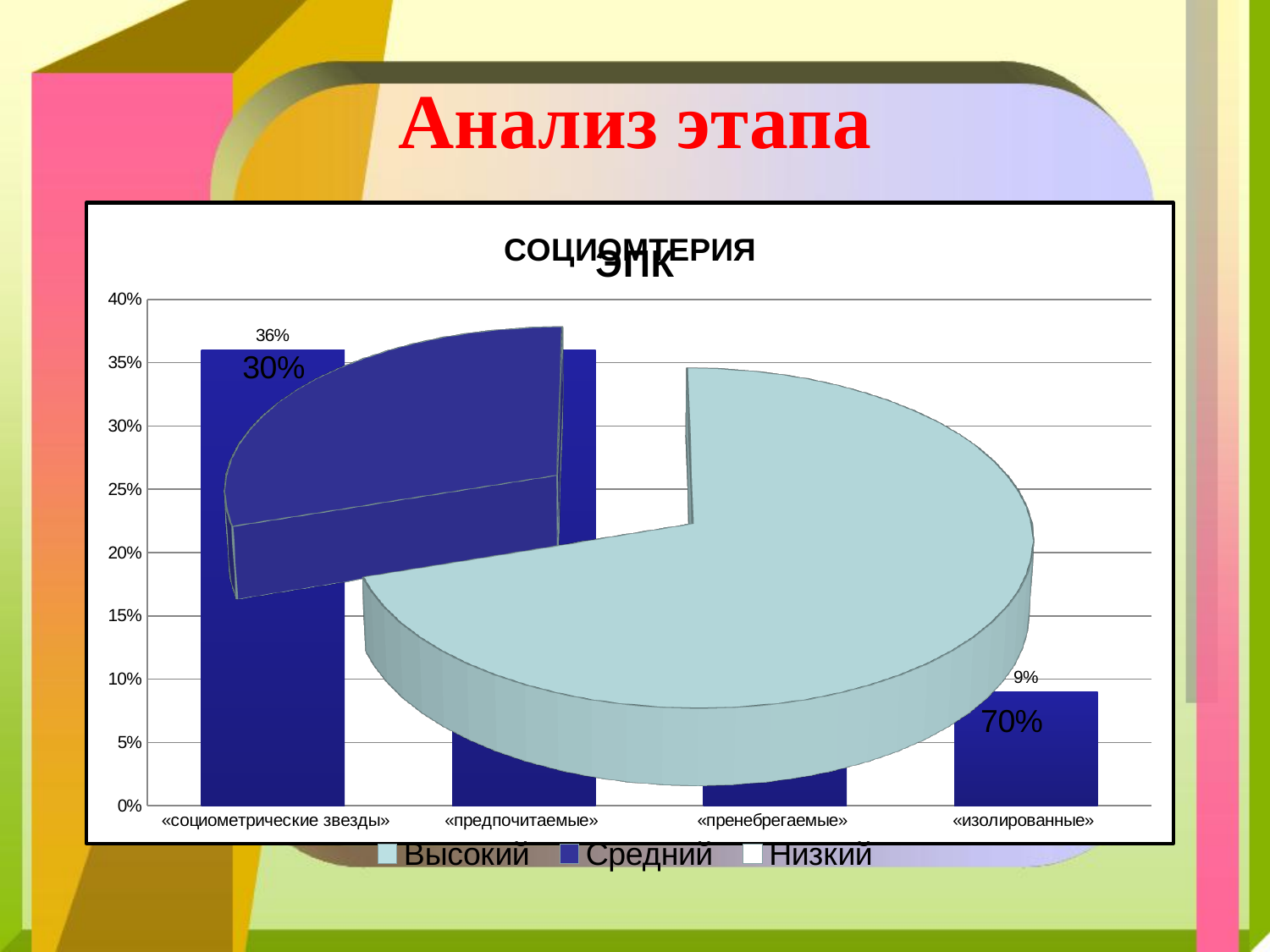
What kind of chart is the chart titled «ЭПК»? Pie chart In the bar chart titled «СОЦИОМЕТРИЯ», what is the value for «социометрические звезды»? 36% In the bar chart titled «СОЦИОМЕТРИЯ», what is the difference between the values for «социометрические звезды» and «изолированные»? 27 percentage points In the pie chart titled «ЭПК», what share does the «Высокий» slice have? 70% In the bar chart titled «СОЦИОМЕТРИЯ», is the value for «предпочитаемые» greater or less than 30%? greater How many entries does the legend of the pie chart titled «ЭПК» list? 3 In the pie chart titled «ЭПК», what share does the «Средний» slice have? 30% How many categories are shown on the x axis of the bar chart titled «СОЦИОМЕТРИЯ»? 4 In the bar chart titled «СОЦИОМЕТРИЯ», which is larger: the value for «социометрические звезды» or for «изолированные»? «социометрические звезды» In the bar chart titled «СОЦИОМЕТРИЯ», what is the value for «изолированные»? 9% In the bar chart titled «СОЦИОМЕТРИЯ», which category has the lowest value? «изолированные»